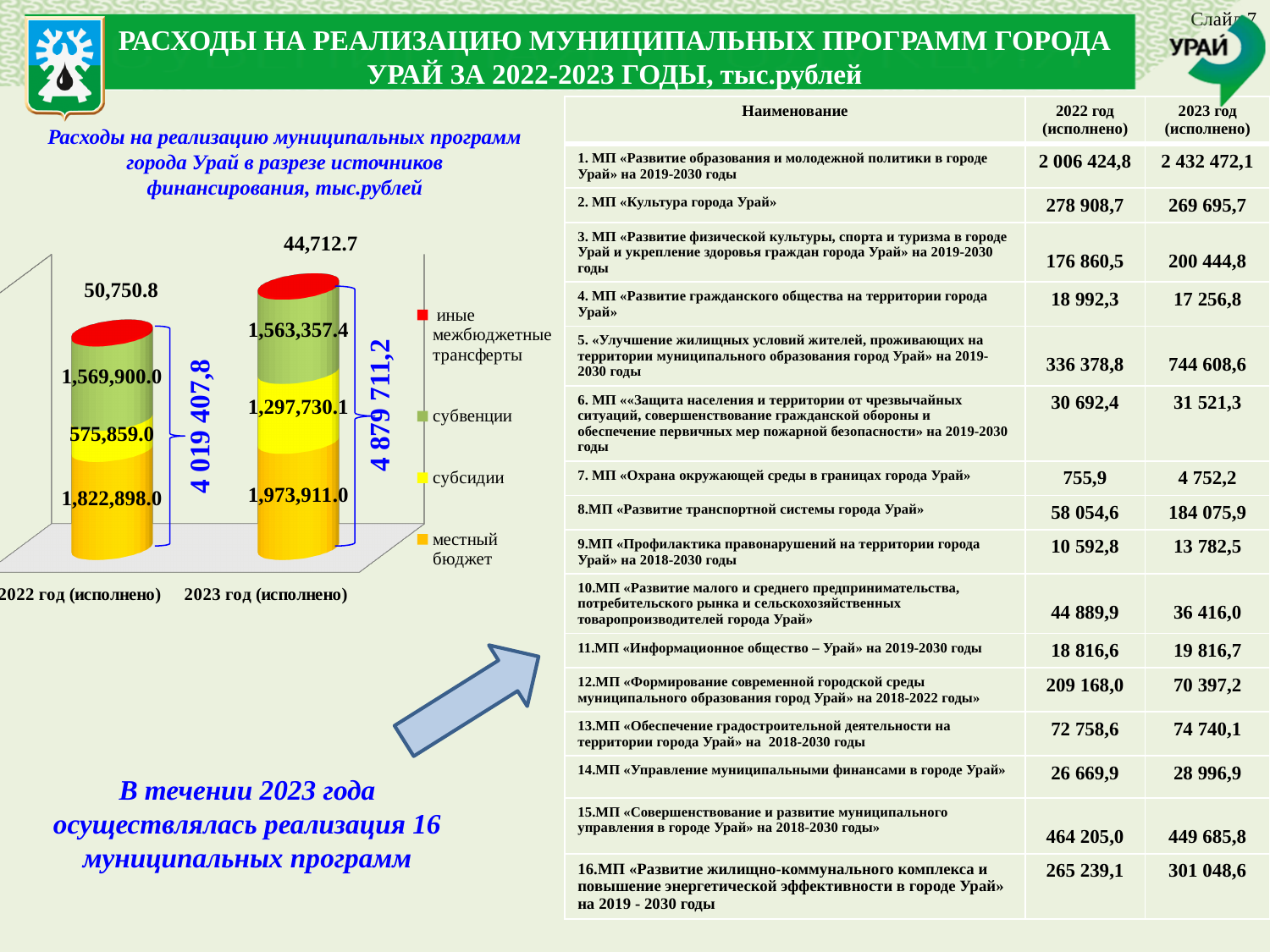
What is the total of the stacked bar for 2022 год (исполнено)? 4 019 407,8 What is the value of иные межбюджетные трансферты for 2022 год (исполнено)? 50,750.8 What is the total of the stacked bar for 2023 год (исполнено)? 4 879 711,2 What kind of chart is shown on the slide? bar chart What is the value of местный бюджет for 2022 год (исполнено)? 1,822,898.0 What is the difference between the местный бюджет values for 2023 and 2022? 151,013.0 What is the value of субсидии for 2023 год (исполнено)? 1,297,730.1 What is the value of субвенции for 2023 год (исполнено)? 1,563,357.4 Which year has the larger value for субсидии, 2022 or 2023? 2023 год (исполнено) How many categories (years) are plotted on the chart? 2 Which series is shown in red in the chart legend? иные межбюджетные трансферты How many series does the chart legend list? 4